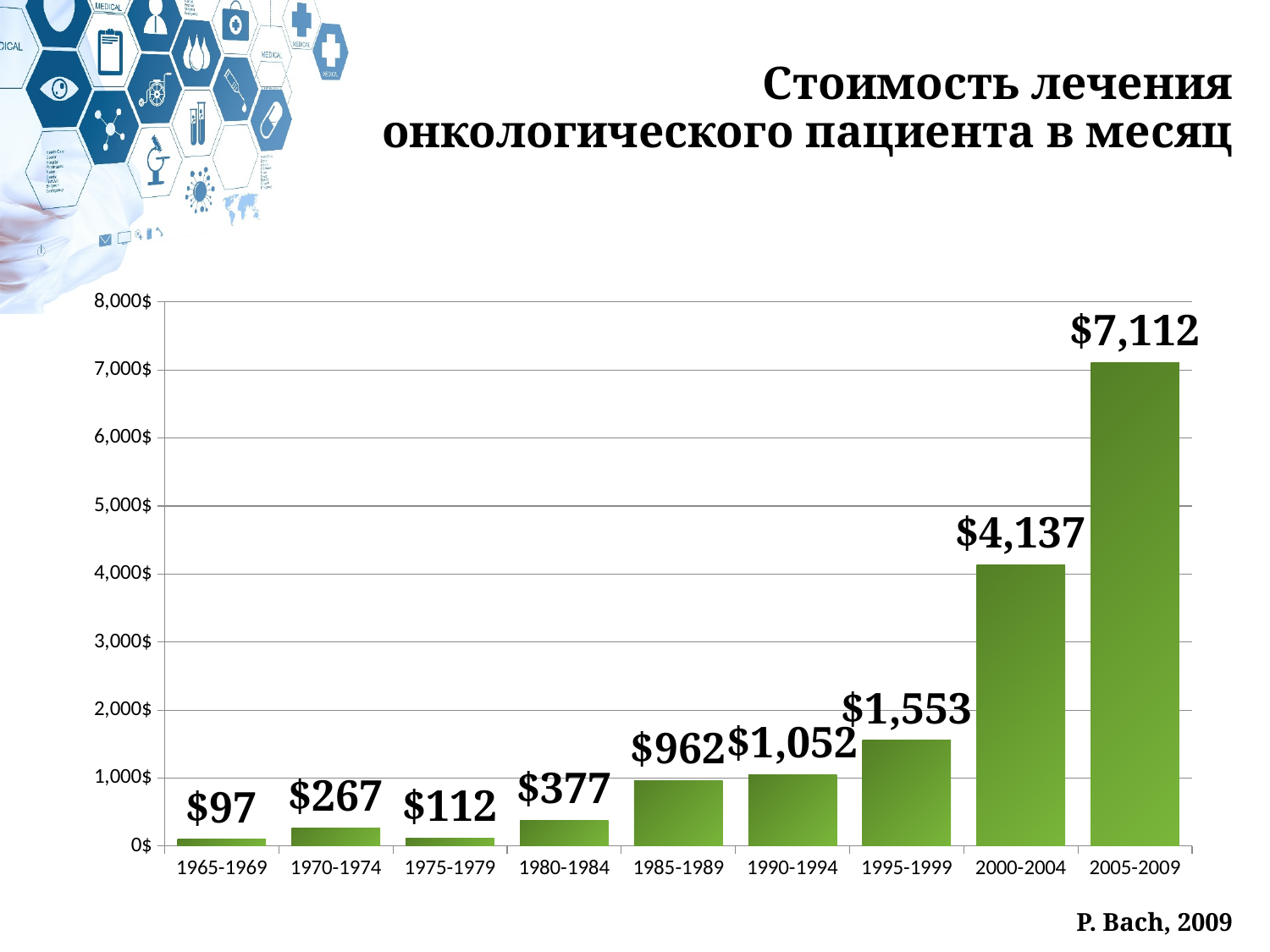
Which period has the highest value? 2005-2009 What is the value for 1985-1989? $962 What is the title of the chart? Стоимость лечения онкологического пациента в месяц What is the value for 1965-1969? $97 Which period has the lowest value? 1965-1969 What is the value for 2000-2004? $4,137 Is the value for 2000-2004 greater or less than 4,000$? greater What is the difference between the values for 1970-1974 and 1975-1979? $155 Which is larger, the value for 1990-1994 or the value for 1995-1999? 1995-1999 What kind of chart is shown on the slide? bar chart What is the difference between the values for 2005-2009 and 2000-2004? $2,975 How many periods are shown on the x axis? 9